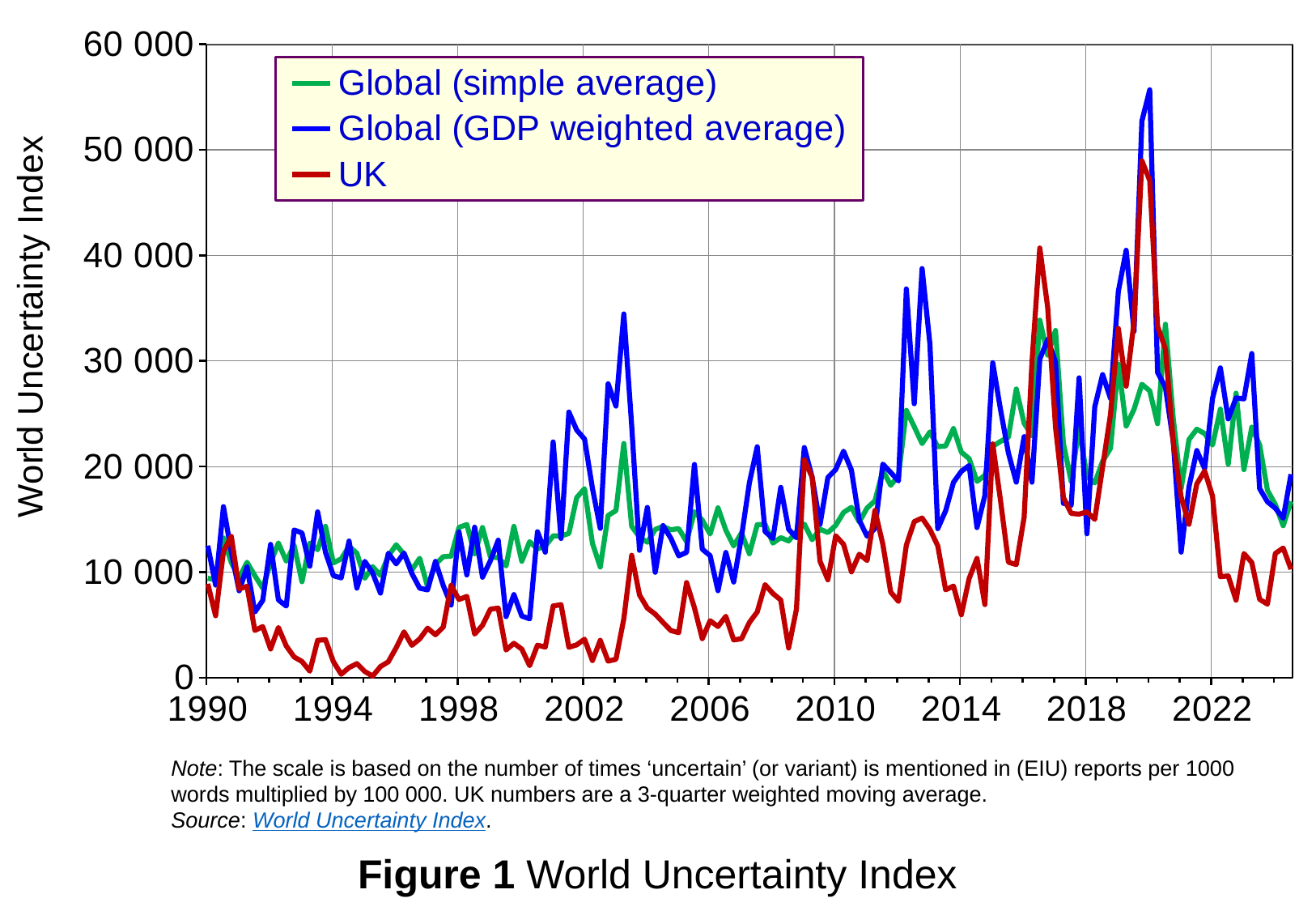
Is the UK peak around 2016-2017 greater or less than 30 000? greater Is the Global (simple average) value in 1990 greater or less than 20 000? less Is the peak value of the Global (GDP weighted average) series around 2020 greater or less than 50 000? greater Does the UK series rise or fall between 1990 and 1995? fall How many series does the legend of the World Uncertainty Index chart list? 3 What colour is the UK series on the chart? Red At the 2020 peak, which is higher: Global (GDP weighted average) or Global (simple average)? Global (GDP weighted average) What kind of chart is shown in Figure 1? Line chart Around 1995, which is higher: the UK series or the Global (simple average) series? Global (simple average) Which series reaches the highest peak on the World Uncertainty Index chart? Global (GDP weighted average)